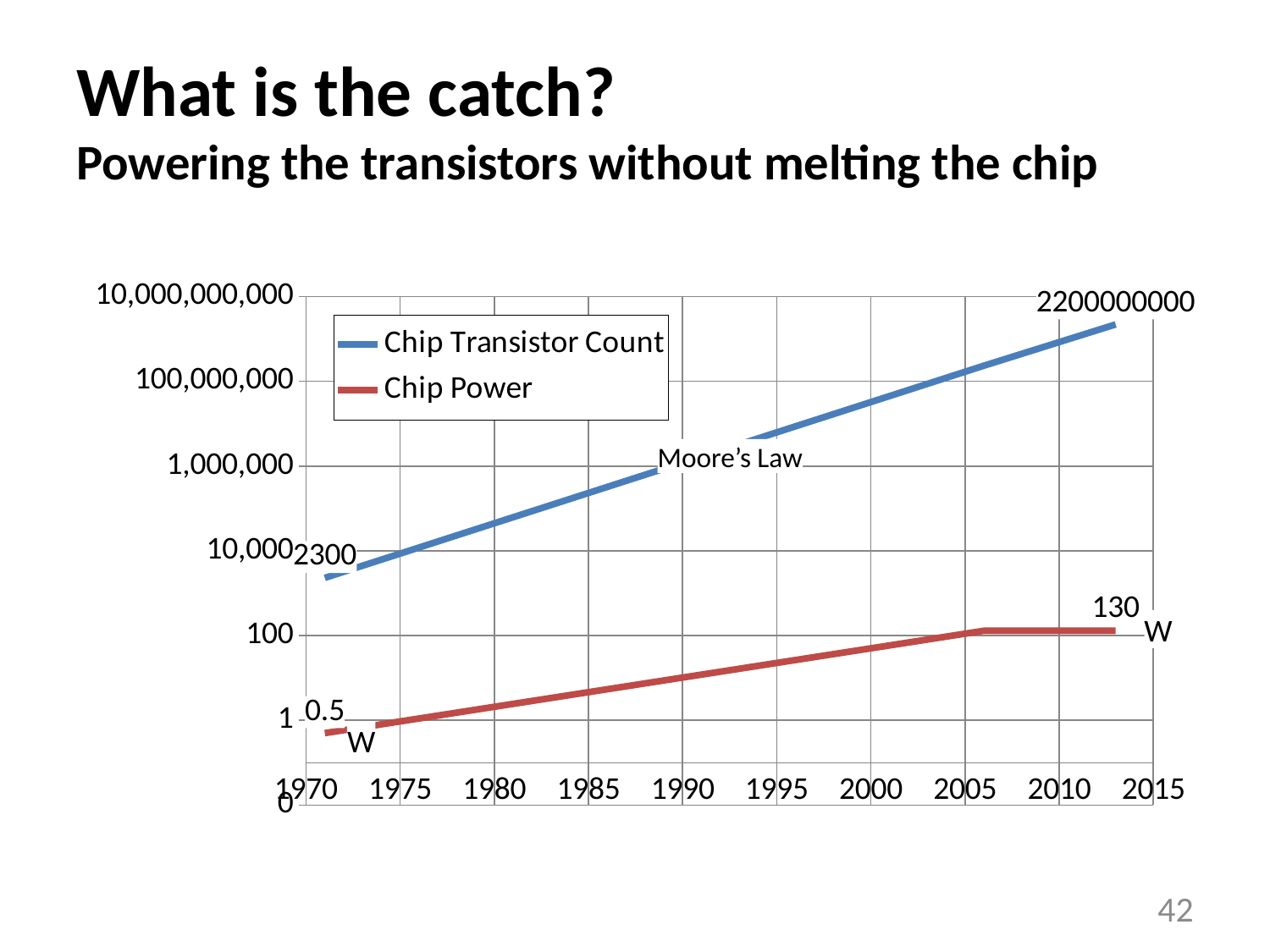
What text annotation is placed along the Chip Transistor Count line? Moore's Law What kind of chart is shown on the slide? line chart Around 2010, which series has the larger value, Chip Transistor Count or Chip Power? Chip Transistor Count What are the two series named in the chart legend? Chip Transistor Count and Chip Power How many series does the chart legend list? 2 What is the last labelled value of the Chip Power series? 130 W What is the first labelled value of the Chip Power series? 0.5 W What is the first labelled value of the Chip Transistor Count series? 2300 Is the Chip Power value around 1990 greater or less than 100? less Does the Chip Transistor Count series rise or fall from 1970 to 2015? rise What is the last labelled value of the Chip Transistor Count series? 2200000000 By how much does the labelled Chip Power value increase from its first label to its last label? 129.5 W